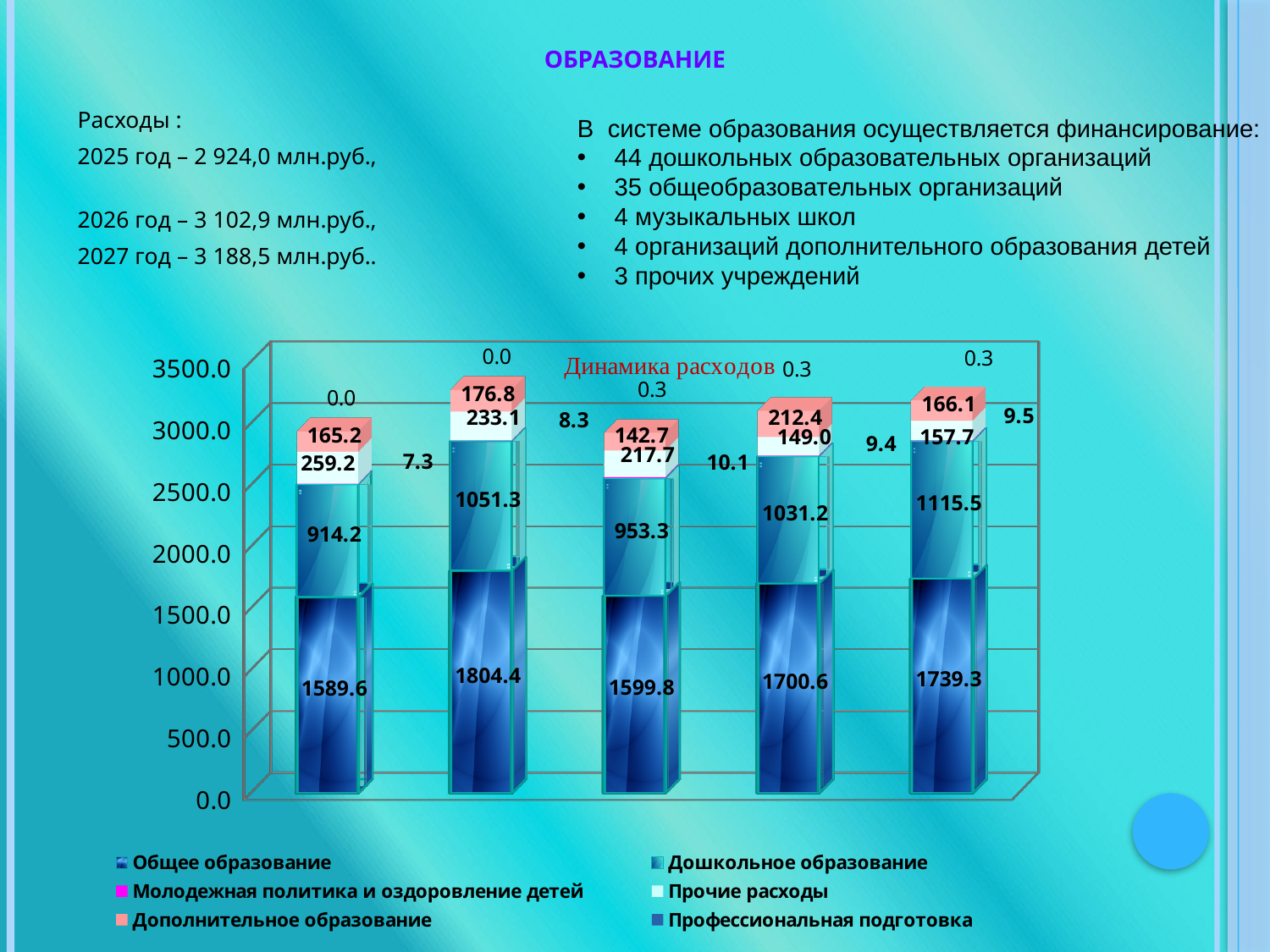
What is the value of Дошкольное образование in the second bar from the left? 1051.3 What is the value of Прочие расходы in the fifth (rightmost) bar? 157.7 What is the value of Общее образование in the first (leftmost) bar? 1589.6 What is the difference between the Общее образование values of the second bar (1804.4) and the first bar (1589.6)? 214.8 How many series does the chart legend list? 6 What kind of chart is shown on the slide? stacked bar chart Which is larger: Дошкольное образование in the third bar or in the fourth bar? the fourth bar (1031.2) Which bar has the highest value for Общее образование? the second bar from the left (1804.4) How many bars are plotted in the chart? 5 What is the title of the chart on the slide? Динамика расходов What is the value of Дополнительное образование in the fourth bar from the left? 212.4 Which bar has the lowest value for Дошкольное образование? the first (leftmost) bar (914.2)